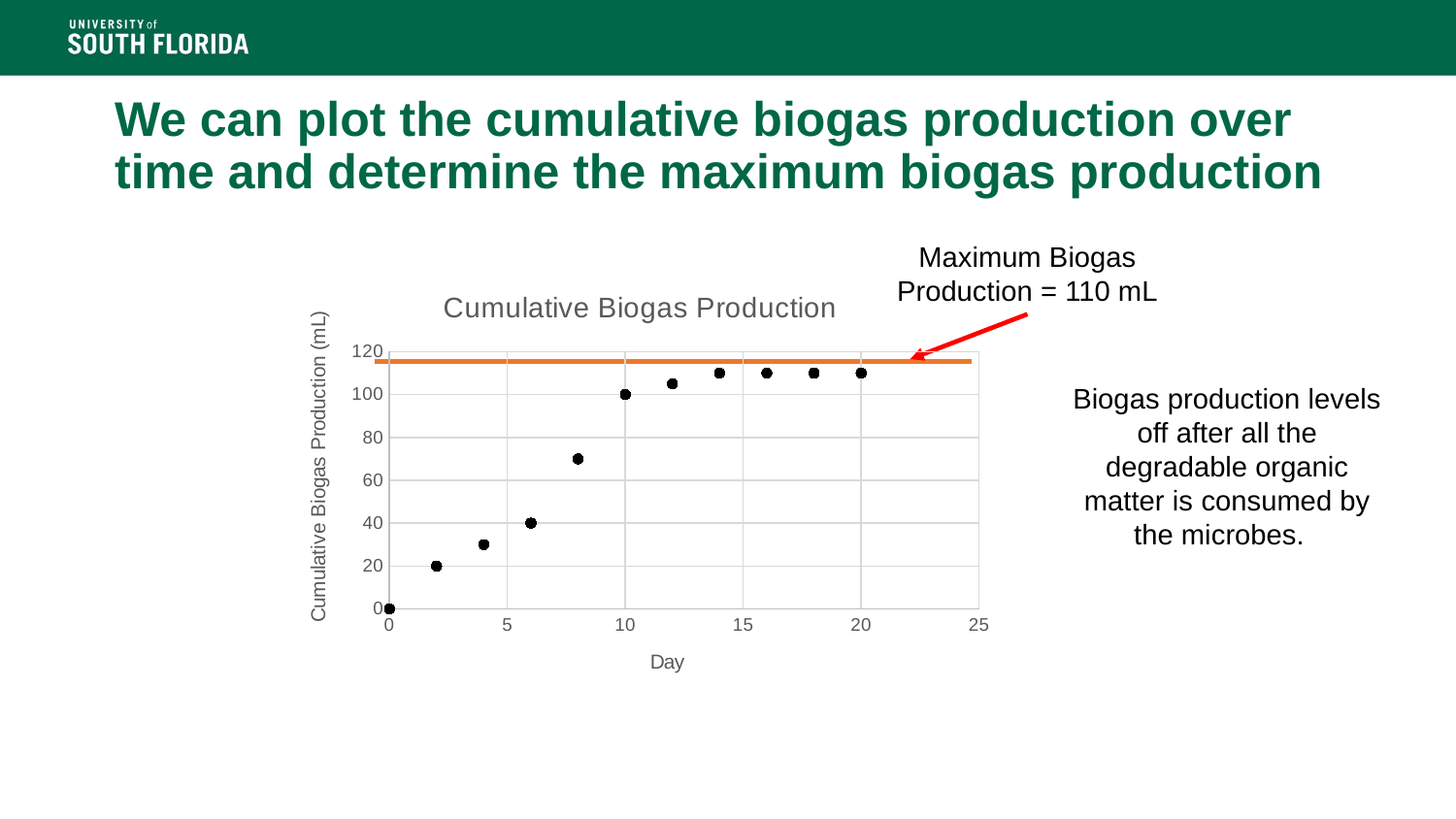
What is the label of the x axis? Day How many data points are plotted on the chart? 11 What is the title of the chart? Cumulative Biogas Production What is the cumulative biogas production on day 2? 20 Which is larger, the value on day 6 or the value on day 10? Day 10 Is the value on day 4 greater or less than 40? less What is the cumulative biogas production on day 10? 100 Is the value on day 8 greater or less than 60? greater What is the maximum biogas production shown on the slide? 110 mL What is the cumulative biogas production on day 0? 0 What type of chart is shown on the slide? Scatter chart How does cumulative biogas production change over the days shown? It rises and then levels off